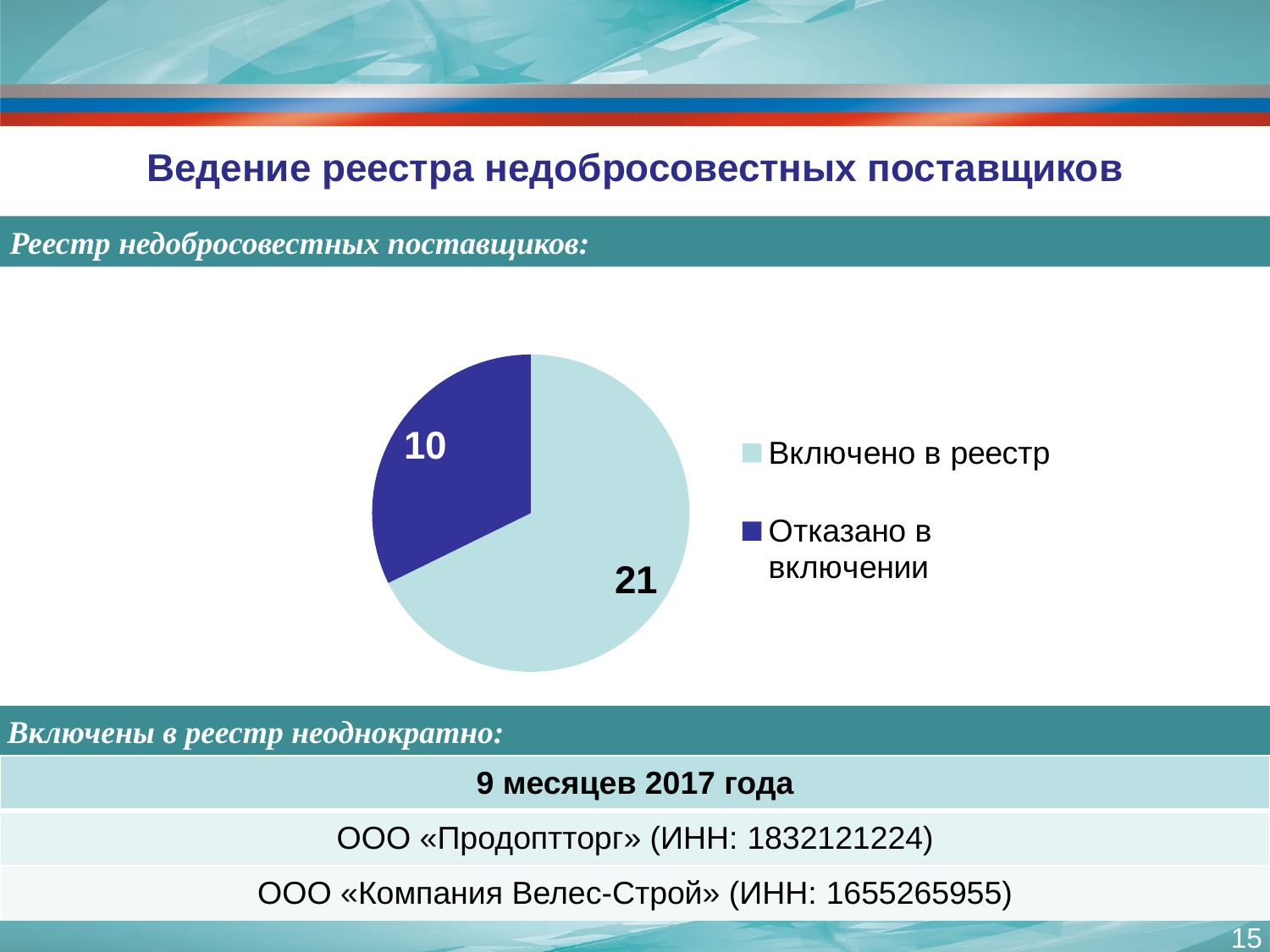
Which is larger: «Включено в реестр» or «Отказано в включении»? Включено в реестр What colour is the slice for «Отказано в включении»? dark blue What colour is the slice for «Включено в реестр»? light blue Which category has the largest slice of the pie? Включено в реестр Which category has the smallest slice of the pie? Отказано в включении What is the value for «Отказано в включении»? 10 How many entries does the legend list? 2 What type of chart is shown on the slide? pie chart What is the total of the two slices in the pie chart? 31 What is the value for «Включено в реестр»? 21 What is the difference between the values for «Включено в реестр» and «Отказано в включении»? 11 How many slices does the pie chart have? 2